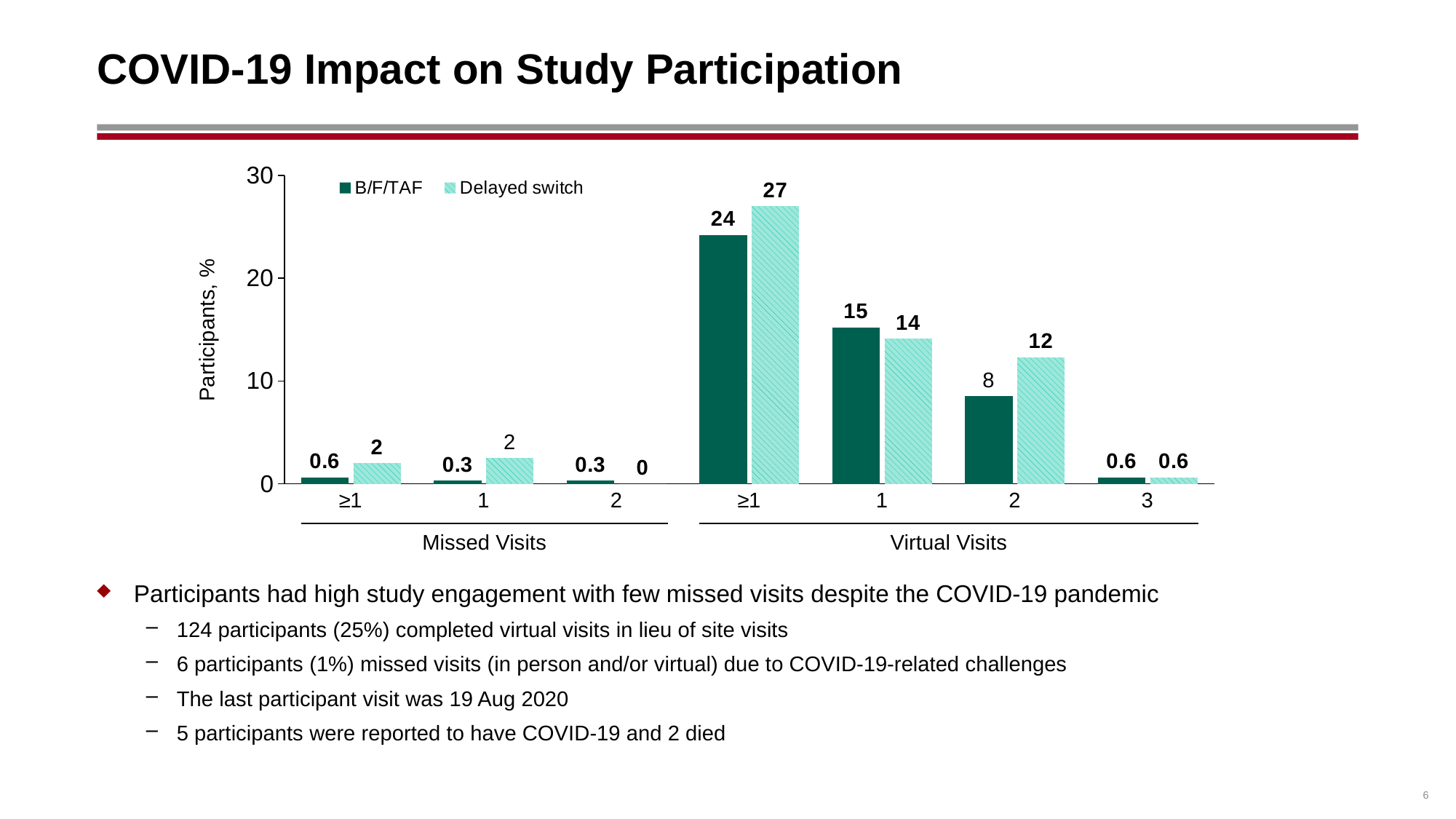
What is the value for Delayed switch for ≥1 Virtual Visits? 27 Which category has the highest Delayed switch value? ≥1 Virtual Visits What is the label of the y axis? Participants, % For 1 Virtual Visit, which is larger: B/F/TAF or Delayed switch? B/F/TAF What kind of chart is shown on the slide? Bar chart What is the value for B/F/TAF for ≥1 Virtual Visits? 24 What is the value for Delayed switch for 2 Missed Visits? 0 How many series does the legend list? 2 What is the difference between the Delayed switch and B/F/TAF values for 2 Virtual Visits? 4 What is the difference between the Delayed switch and B/F/TAF values for ≥1 Virtual Visits? 3 What is the value for B/F/TAF for 2 Virtual Visits? 8 What is the value for B/F/TAF for ≥1 Missed Visits? 0.6